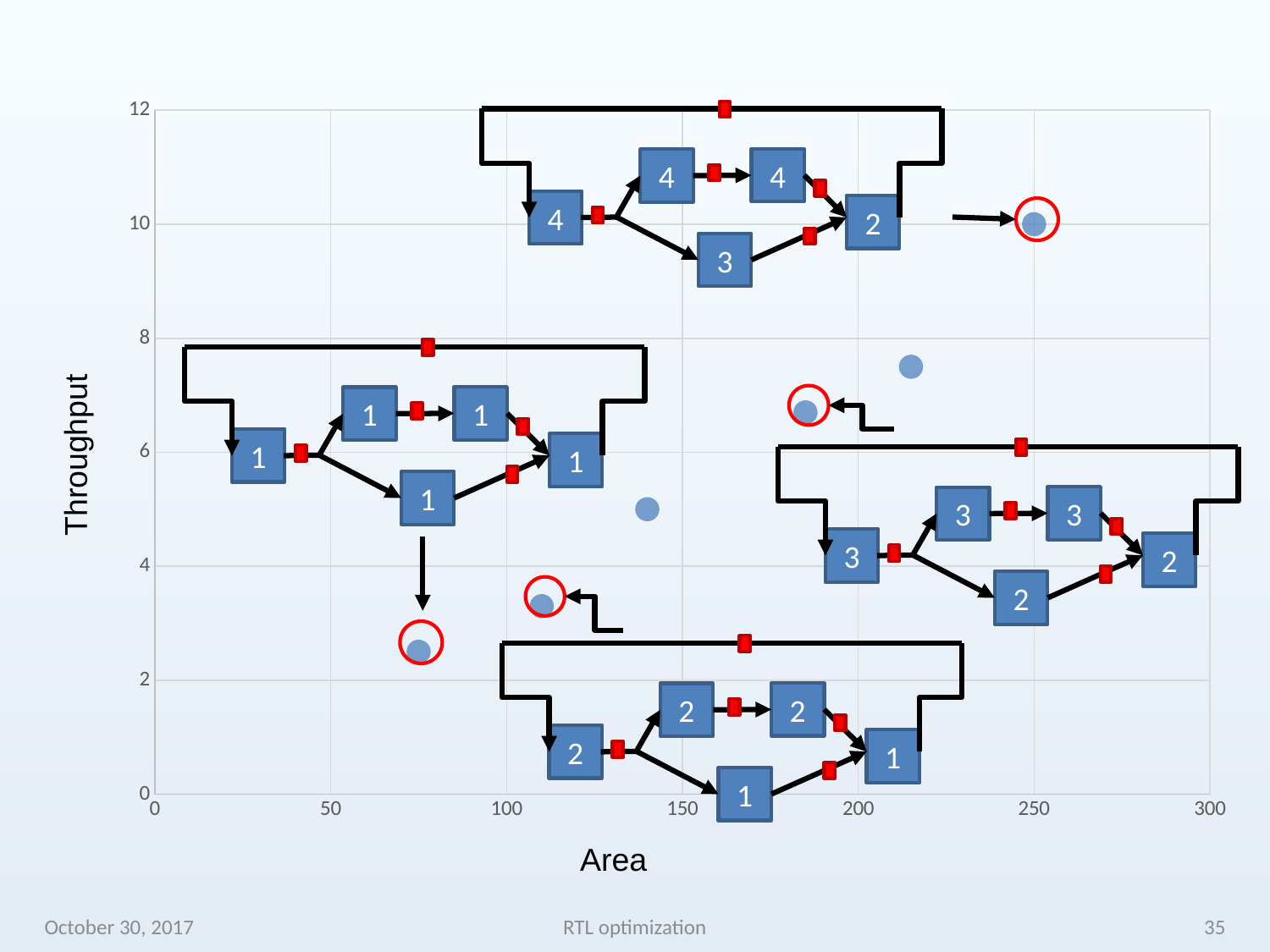
What is the label of the y axis? Throughput How many of the plotted points are circled in red? 4 Which has the higher Throughput: the point with the smallest Area or the point with the largest Area? the point with the largest Area How many data points are plotted on the chart? 6 Do the Throughput values generally rise or fall as Area increases along the x axis? rise What is the label of the x axis? Area Is the Area of the point with the lowest Throughput greater or less than 100? less Is the Throughput of the point with the smallest Area greater or less than 4? less What is the maximum value shown on the Throughput axis? 12 Is the Area of the point with the highest Throughput greater or less than 200? greater What kind of chart is shown on the slide? scatter chart